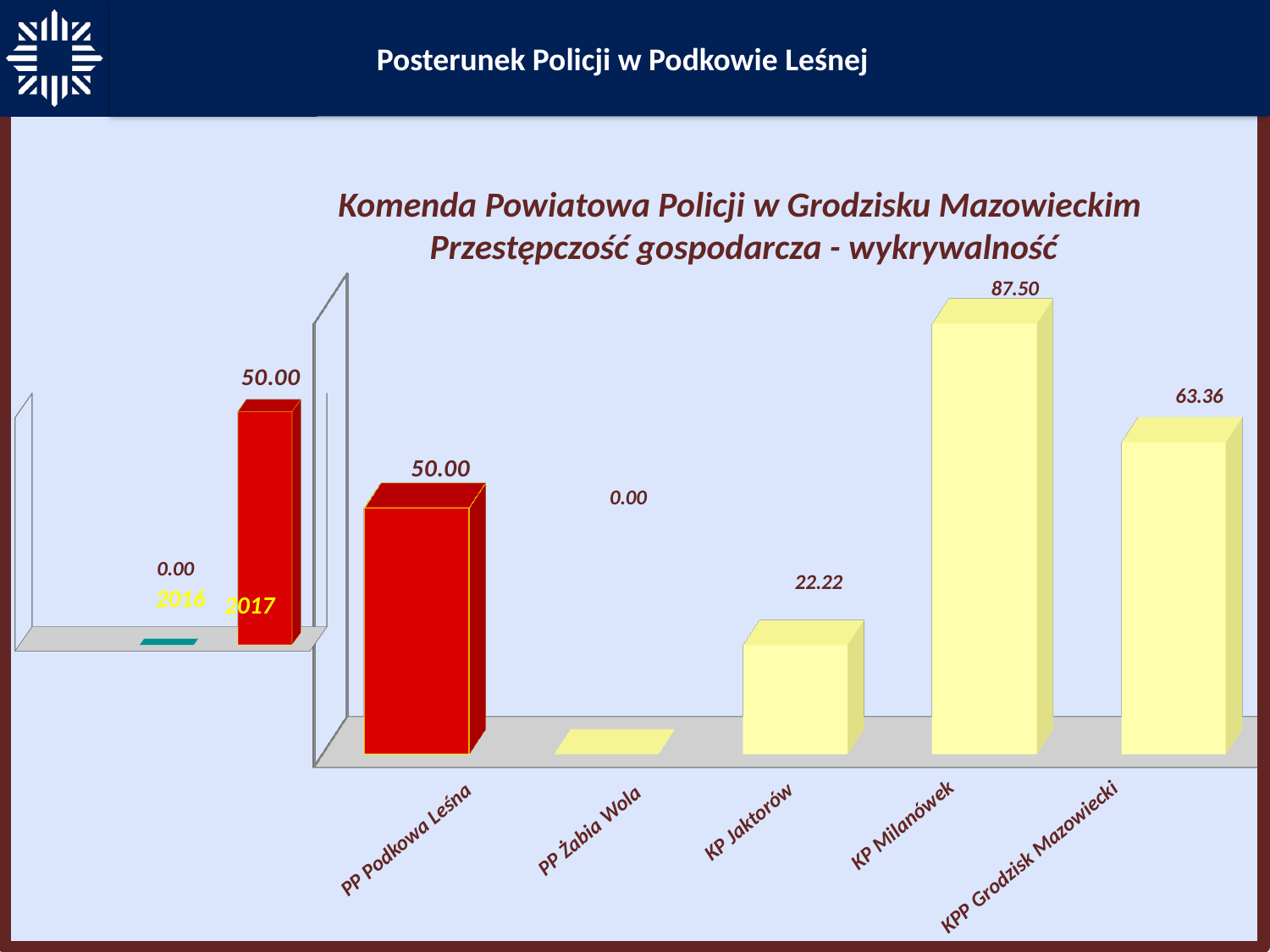
In the small chart on the left with years 2016 and 2017, what is the value for 2017? 50.00 In the small chart on the left with years 2016 and 2017, do the values rise or fall from 2016 to 2017? rise In the large chart titled 'Przestępczość gospodarcza - wykrywalność', which category has the highest value? KP Milanówek In the large chart titled 'Przestępczość gospodarcza - wykrywalność', which is larger, the value for PP Podkowa Leśna or the value for KP Jaktorów? PP Podkowa Leśna In the large chart titled 'Przestępczość gospodarcza - wykrywalność', what is the value for KP Jaktorów? 22.22 What kind of chart is the large chart titled 'Przestępczość gospodarcza - wykrywalność'? bar chart In the large chart titled 'Przestępczość gospodarcza - wykrywalność', what is the value for KPP Grodzisk Mazowiecki? 63.36 In the small chart on the left with years 2016 and 2017, what is the value for 2016? 0.00 In the large chart titled 'Przestępczość gospodarcza - wykrywalność', what is the value for KP Milanówek? 87.50 In the large chart titled 'Przestępczość gospodarcza - wykrywalność', which category has the lowest value? PP Żabia Wola In the large chart titled 'Przestępczość gospodarcza - wykrywalność', what is the difference between the values for KP Milanówek and KPP Grodzisk Mazowiecki? 24.14 How many categories are shown in the large chart titled 'Przestępczość gospodarcza - wykrywalność'? 5